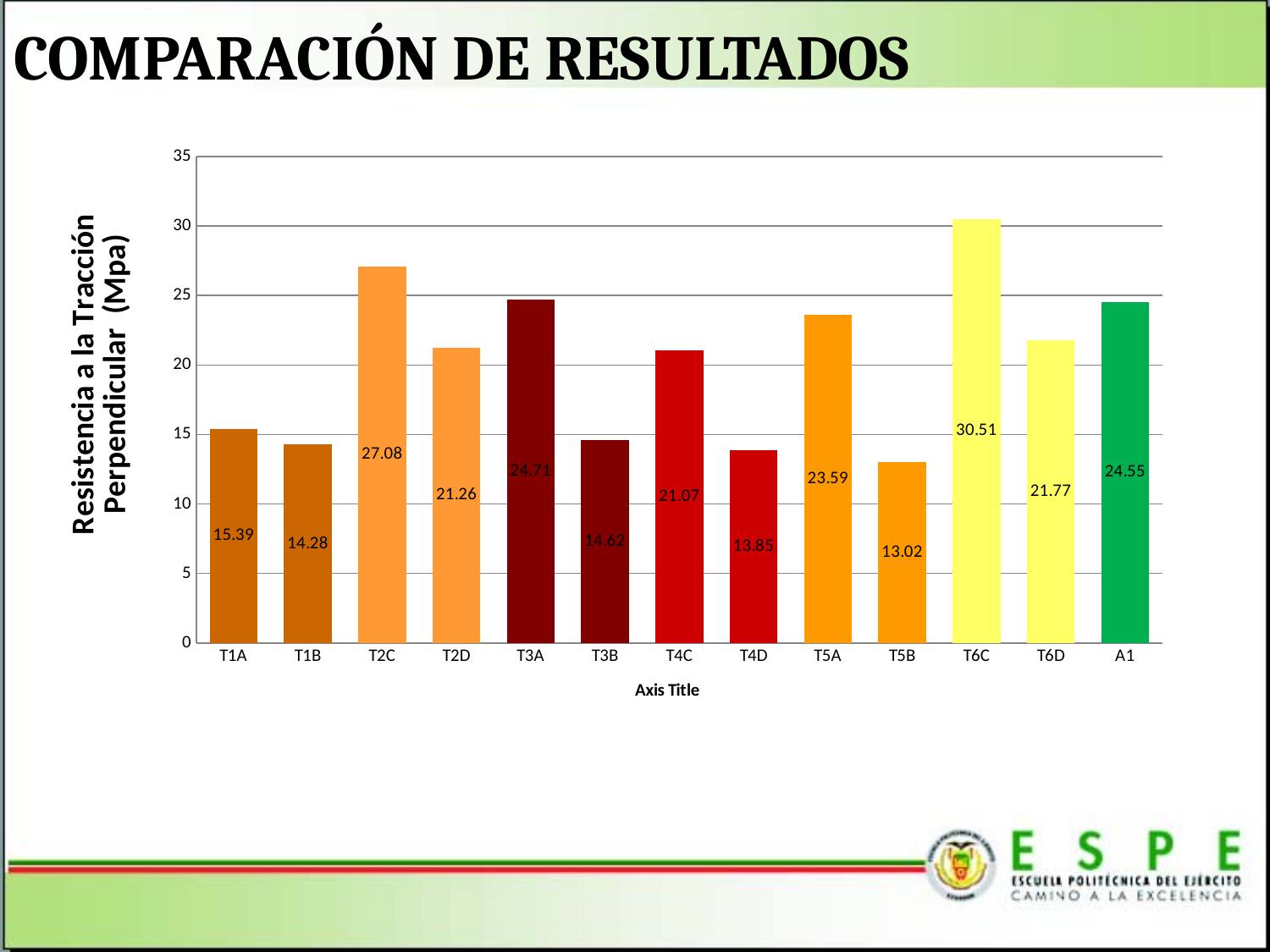
Is the value for T6D greater or less than 20? greater What colour is the bar for A1? green Which category has the lowest value? T5B What kind of chart is shown on the slide? bar chart What is the value for A1? 24.55 What is the value for T2D? 21.26 What is the value for T6C? 30.51 What is the y-axis label of the chart? Resistencia a la Tracción Perpendicular (Mpa) How many categories are shown on the x axis? 13 Which category has the highest value? T6C Which is larger, the value for T3A or the value for T5A? T3A What is the difference between the values for T2C and T1A? 11.69